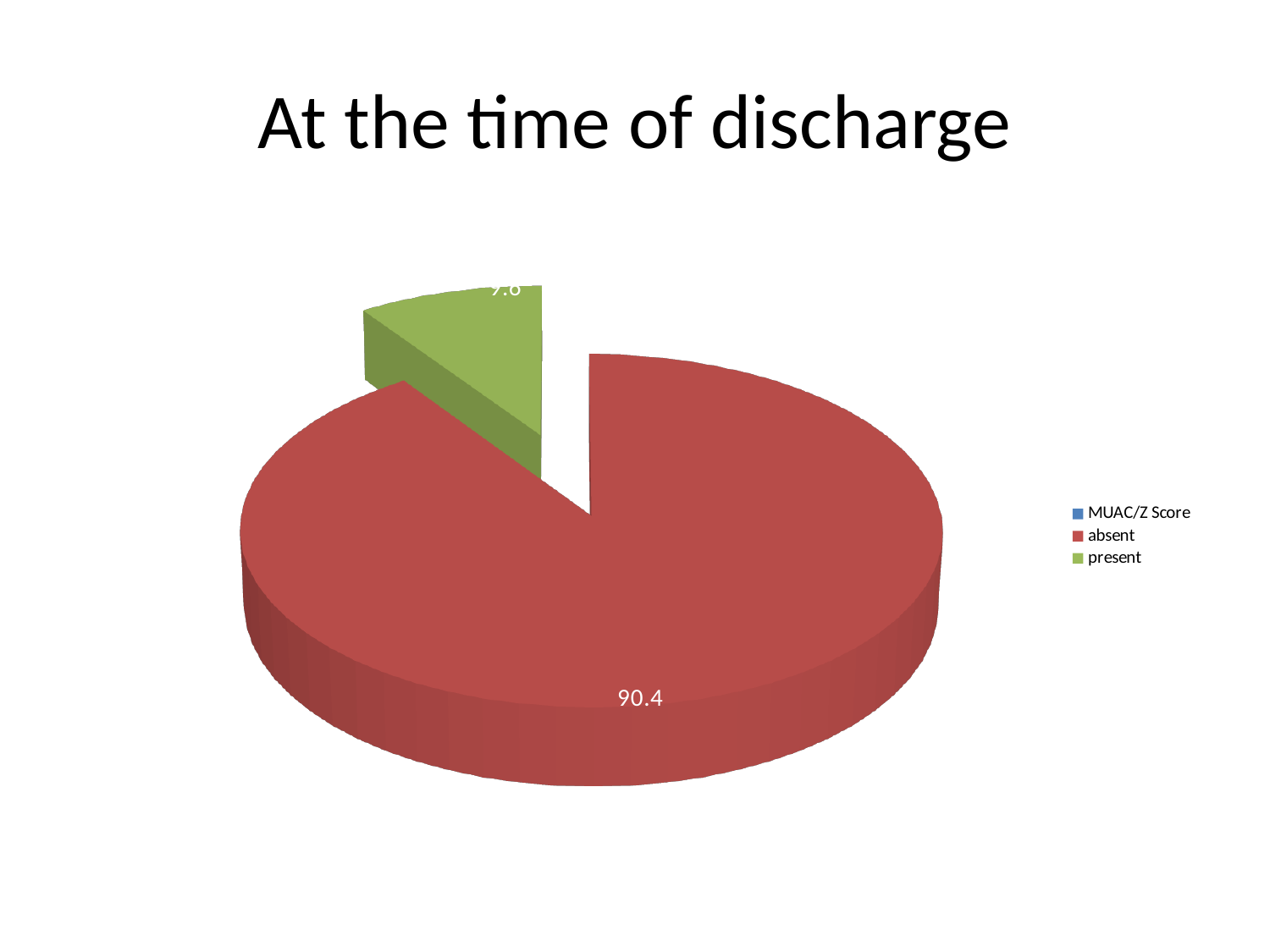
How many slices are visible in the pie? 2 What kind of chart is shown on the slide? pie chart Which category has the largest slice of the pie? absent What value is shown for the 'absent' slice? 90.4 Which category has the smallest visible slice of the pie? present How many entries does the legend list? 3 What is the title of the chart? At the time of discharge Which slice is larger, 'absent' or 'present'? absent What colour is the 'absent' slice? red